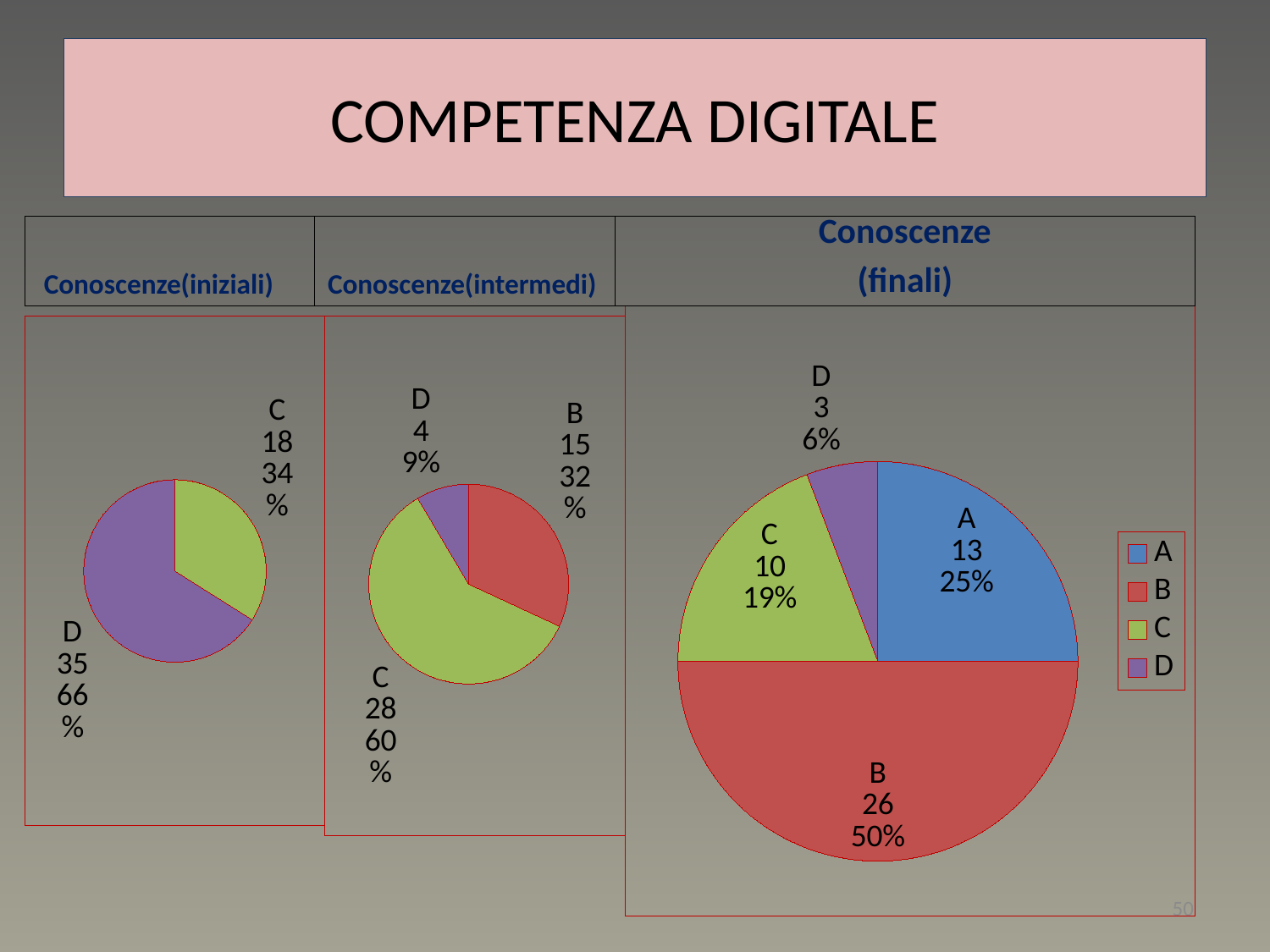
In the Conoscenze(intermedi) chart, what is the value for C? 28 In the Conoscenze(intermedi) chart, what share of the pie does B represent? 32% In the Conoscenze(finali) chart, which category has the highest value? B In the Conoscenze(iniziali) chart, what share of the pie does C represent? 34% In the Conoscenze(finali) chart, what is the value for B? 26 How many categories does the Conoscenze(finali) chart show? 4 In the Conoscenze(finali) chart, which is larger, the value for C or the value for D? C What kind of chart is used for Conoscenze(iniziali)? Pie chart In the Conoscenze(finali) chart, what share of the pie does A represent? 25% In the Conoscenze(finali) chart, what is the difference between the values for B and A? 13 In the Conoscenze(iniziali) chart, what is the value for D? 35 In the Conoscenze(intermedi) chart, which category has the lowest value? D